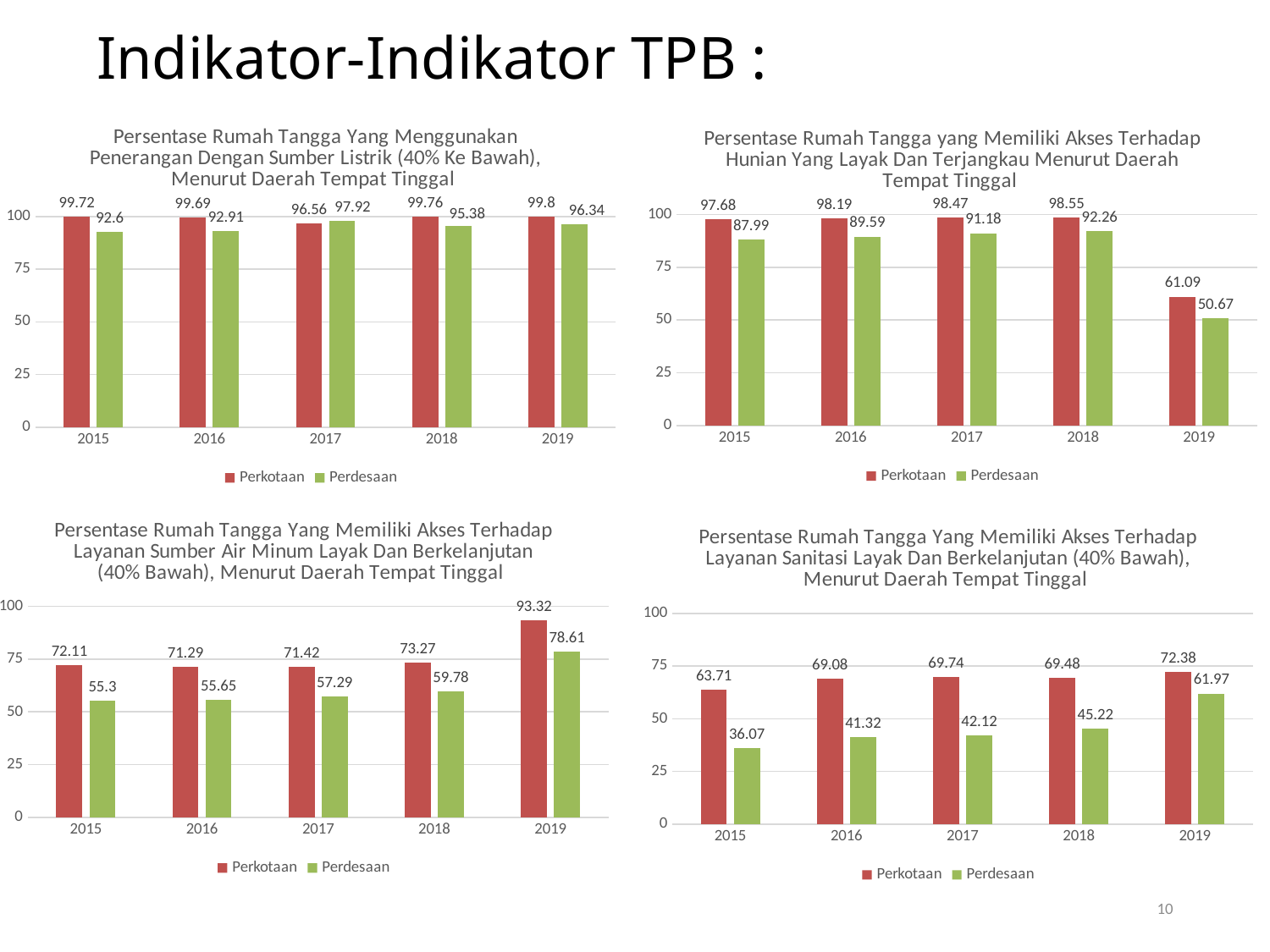
In the top-left chart (Penerangan Dengan Sumber Listrik), which year has the lowest Perkotaan value? 2017 In the top-left chart (Penerangan Dengan Sumber Listrik), what is the Perdesaan value for 2017? 97.92 In the bottom-left chart (Layanan Sumber Air Minum), which is larger: the Perkotaan value for 2016 or the Perkotaan value for 2018? 2018 What kind of chart is the top-right chart (Hunian Yang Layak Dan Terjangkau)? bar chart In the bottom-left chart (Layanan Sumber Air Minum), what is the Perdesaan value for 2019? 78.61 In the bottom-right chart (Layanan Sanitasi), what is the difference between the Perkotaan and Perdesaan values for 2019? 10.41 In the bottom-right chart (Layanan Sanitasi), what is the Perdesaan value for 2015? 36.07 In the top-right chart (Hunian Yang Layak Dan Terjangkau), which year has the highest Perdesaan value? 2018 In the bottom-right chart (Layanan Sanitasi), do the Perdesaan values rise or fall from 2015 to 2019? rise How many series does the legend of the bottom-left chart (Layanan Sumber Air Minum) list? 2 In the top-right chart (Hunian Yang Layak Dan Terjangkau), what is the Perkotaan value for 2019? 61.09 In the top-right chart (Hunian Yang Layak Dan Terjangkau), what is the difference between the Perkotaan and Perdesaan values for 2015? 9.69